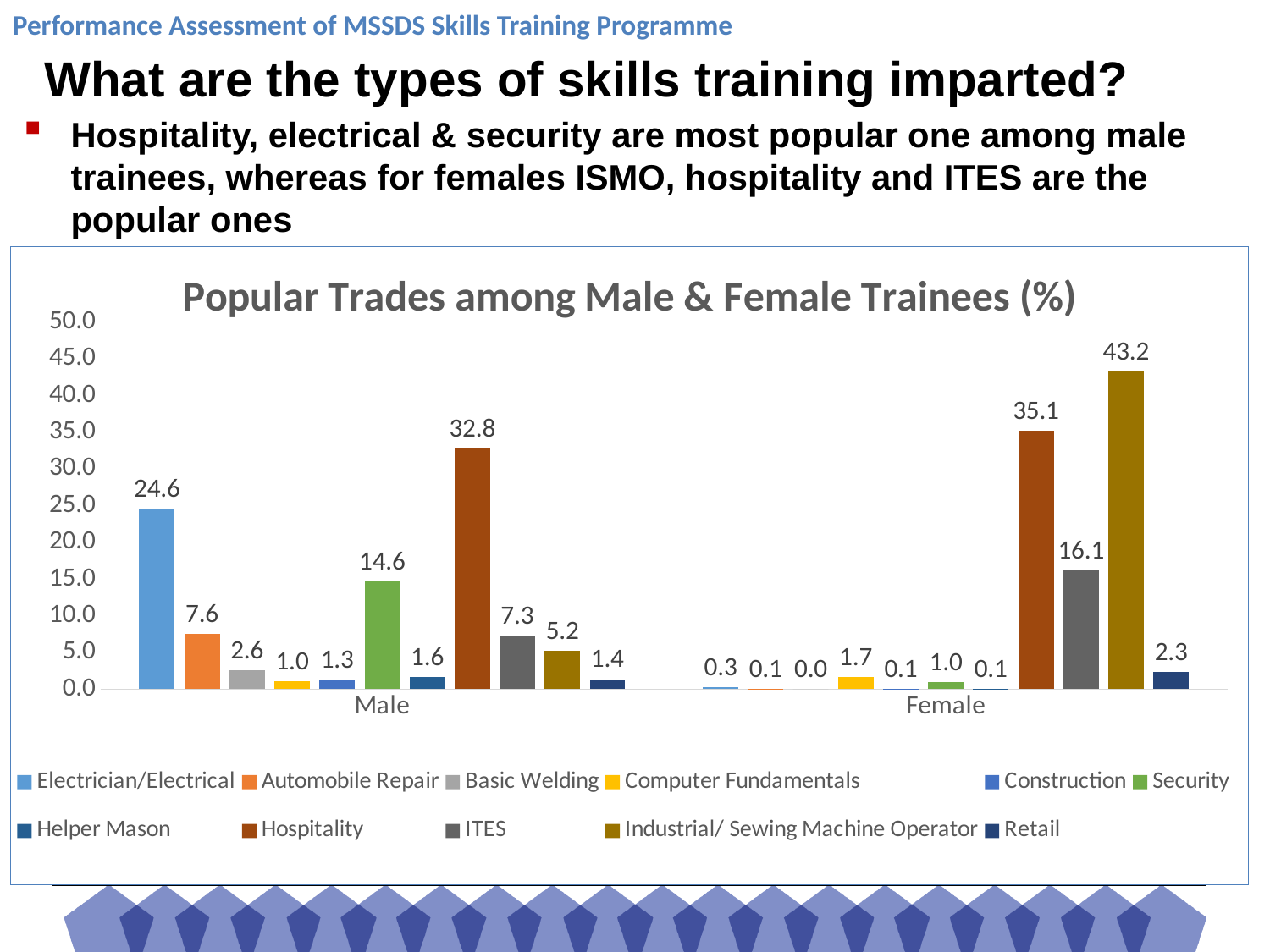
Which is larger: Electrician/Electrical for Male trainees or ITES for Female trainees? Electrician/Electrical for Male trainees How many series does the legend list? 11 What is the value for Industrial/ Sewing Machine Operator among Female trainees? 43.2 What is the value for Security among Male trainees? 14.6 What is the title of the chart? Popular Trades among Male & Female Trainees (%) What is the value for ITES among Female trainees? 16.1 Which trade has the highest value among Female trainees? Industrial/ Sewing Machine Operator What kind of chart is shown on the slide? Bar chart Which trade has the highest value among Male trainees? Hospitality What is the difference between the Hospitality values for Female and Male trainees? 2.3 Which trade has the lowest value among Female trainees? Basic Welding What is the value for Hospitality among Male trainees? 32.8